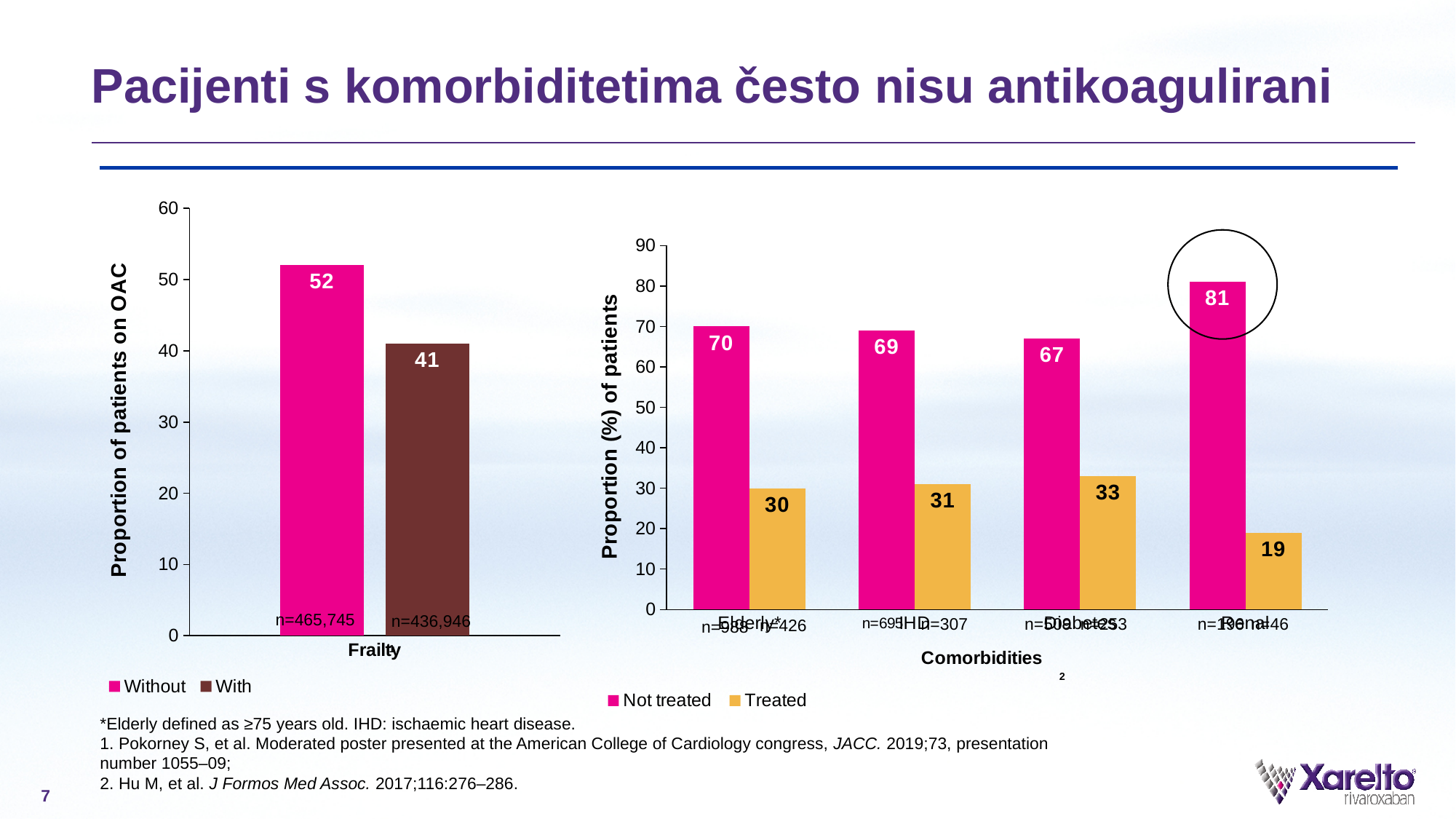
In the right chart (Comorbidities), which category has the lowest Treated value? Renal What type of chart is the right chart (Comorbidities)? Bar chart In the right chart (Comorbidities), how many categories are shown on the x axis? 4 In the left chart (Frailty), what is the difference between the Without and With values? 11 In the left chart (Frailty), what is the value for patients without frailty? 52 In the right chart (Comorbidities), is the Not treated value for IHD larger than the Treated value for IHD? Yes In the left chart (Frailty), what is the value for patients with frailty? 41 In the right chart (Comorbidities), which category has the highest Not treated value? Renal In the left chart (Frailty), how many series does the legend list? 2 In the right chart (Comorbidities), what is the Treated value for Diabetes? 33 In the right chart (Comorbidities), what is the difference between the Not treated and Treated values for Elderly*? 40 In the right chart (Comorbidities), what is the Not treated value for Renal? 81